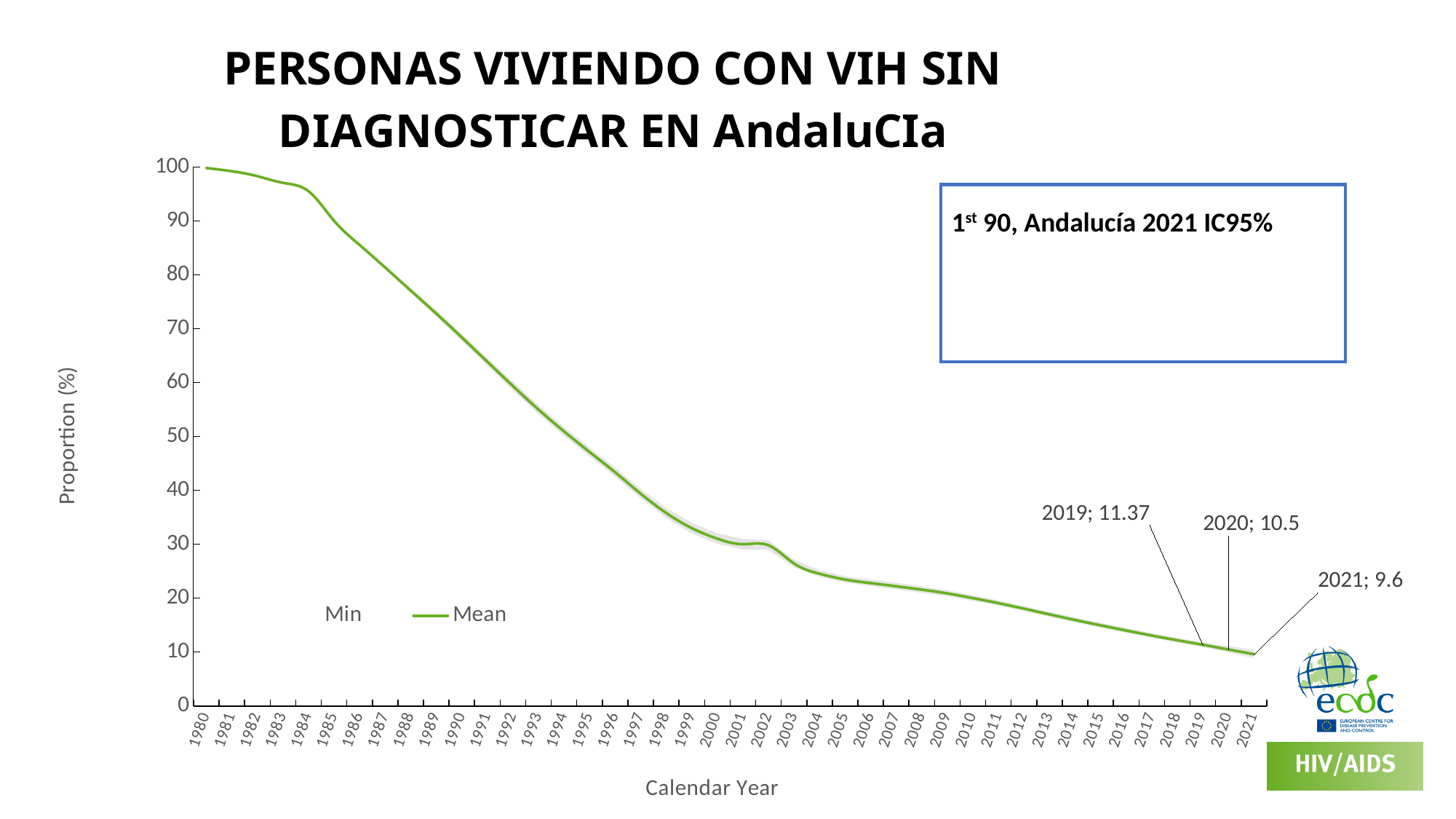
What kind of chart is shown on the slide? line chart Is the Mean value for 2005 greater or less than 30? less Which year has the larger Mean value, 2019 or 2020? 2019 Does the Mean line rise or fall from 1980 to 2021? fall What is the difference between the Mean values for 2019 and 2021? 1.77 How many series does the legend list? 2 What is the Mean value for 2020? 10.5 What is the Mean value for 2019? 11.37 What is the difference between the Mean values for 2020 and 2021? 0.9 What is the label of the y axis? Proportion (%) Is the Mean value for 1990 greater or less than 60? greater What is the Mean value for 2021? 9.6